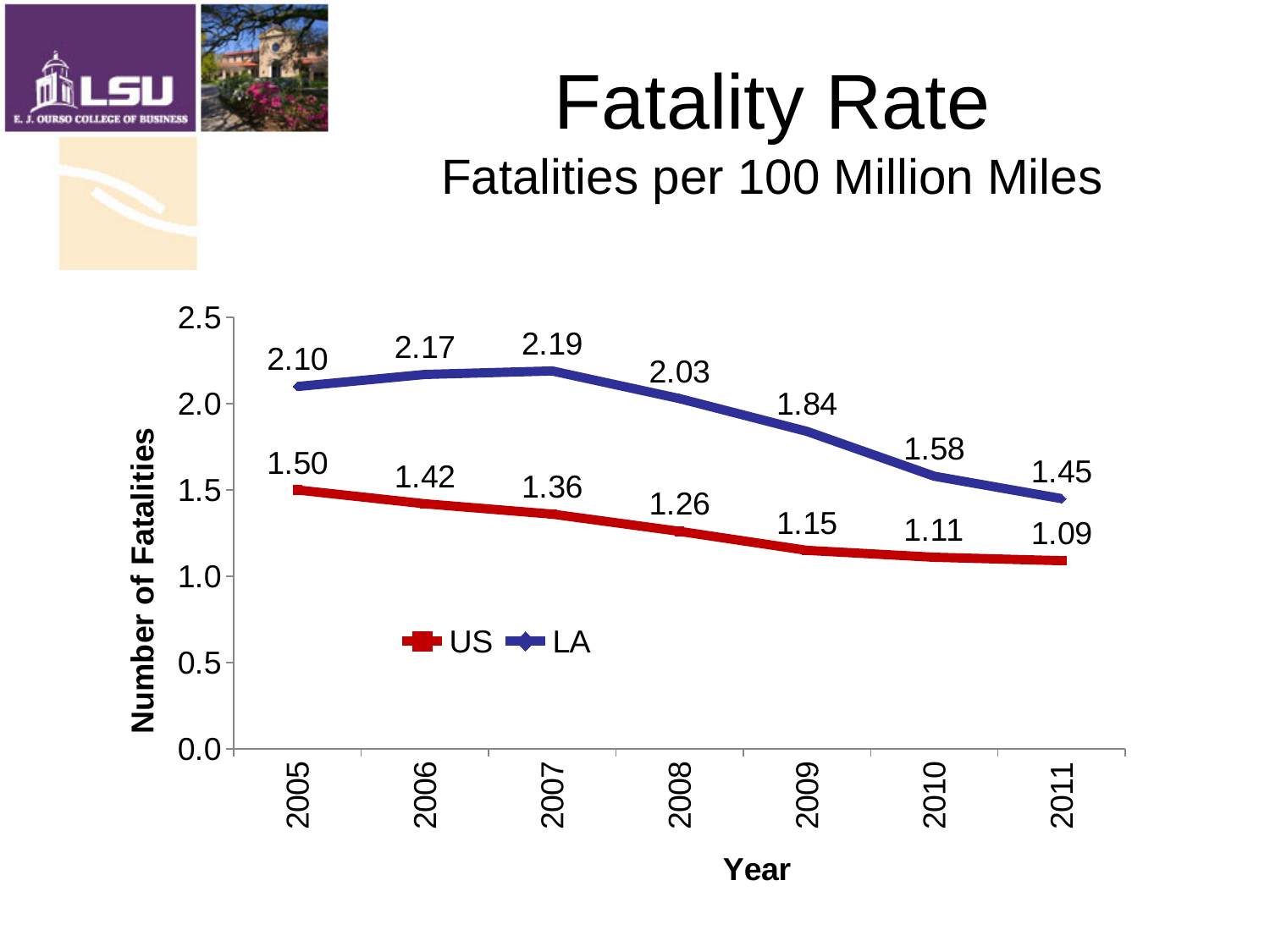
How many years are shown on the x axis? 7 What is the difference between the LA and US fatality rates in 2005? 0.60 How many series does the legend list? 2 In which year is the LA fatality rate highest? 2007 Does the US fatality rate rise or fall from 2005 to 2011? fall What kind of chart is shown on the slide? line chart In which year is the US fatality rate lowest? 2011 Which is larger in 2009, the LA rate or the US rate? LA What is the LA fatality rate in 2007? 2.19 What is the US fatality rate in 2011? 1.09 Is the LA value for 2010 greater or less than 1.5? greater What is the US fatality rate in 2008? 1.26